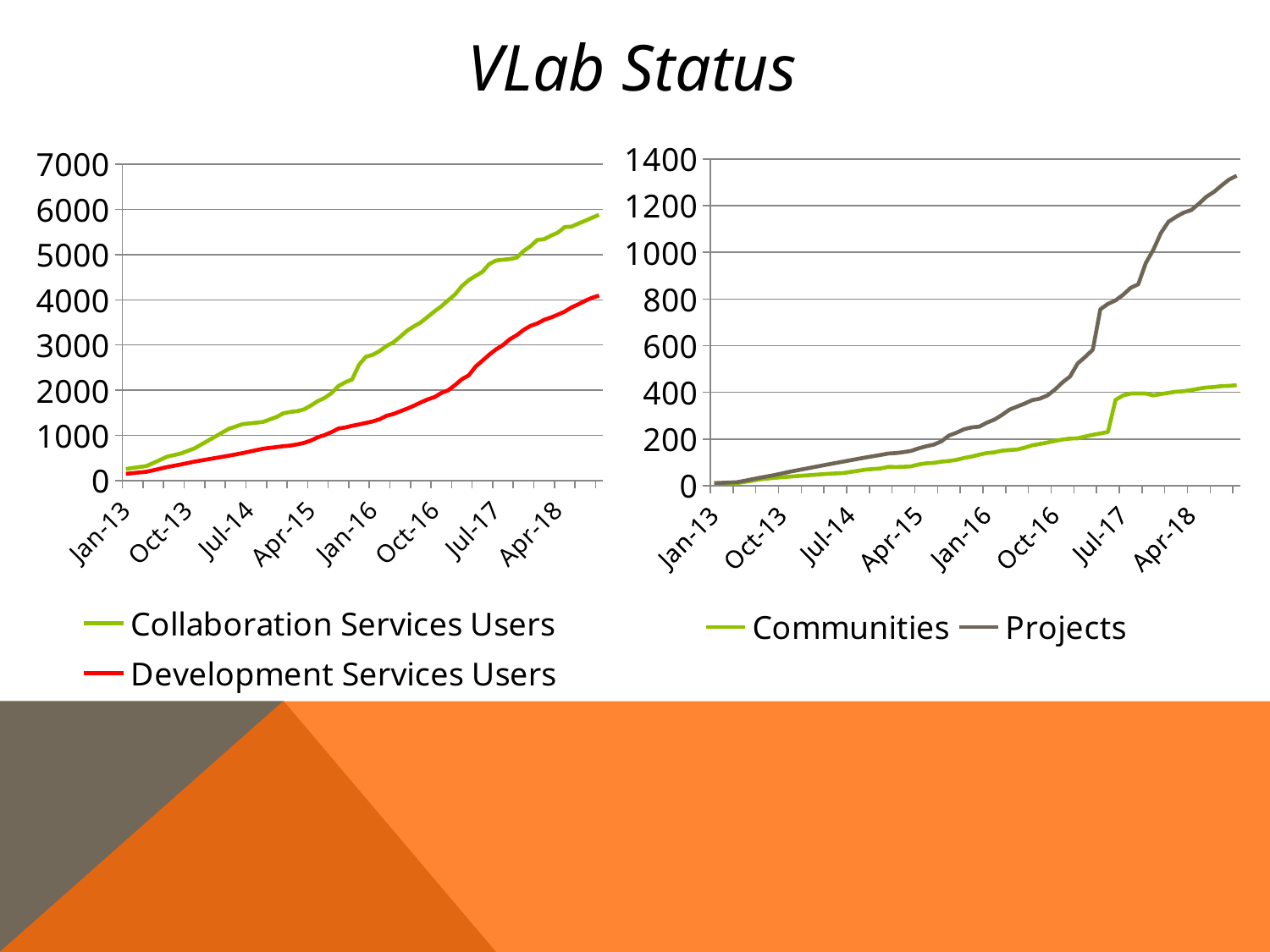
In the left chart, is the value for Collaboration Services Users at Jan-16 greater or less than 3000? less What kind of chart is the left chart on the slide? line chart In the right chart, is the value for Projects at Apr-18 greater or less than 1000? greater In the right chart, is the value for Communities at Apr-18 greater or less than 600? less In the right chart, which series has the larger value at Apr-18, Communities or Projects? Projects How many series does the legend of the left chart list? 2 How many series does the legend of the right chart list? 2 In the right chart, do the values for Projects rise or fall from Jan-13 to Apr-18? rise In the left chart, which series has the larger value at Apr-18, Collaboration Services Users or Development Services Users? Collaboration Services Users